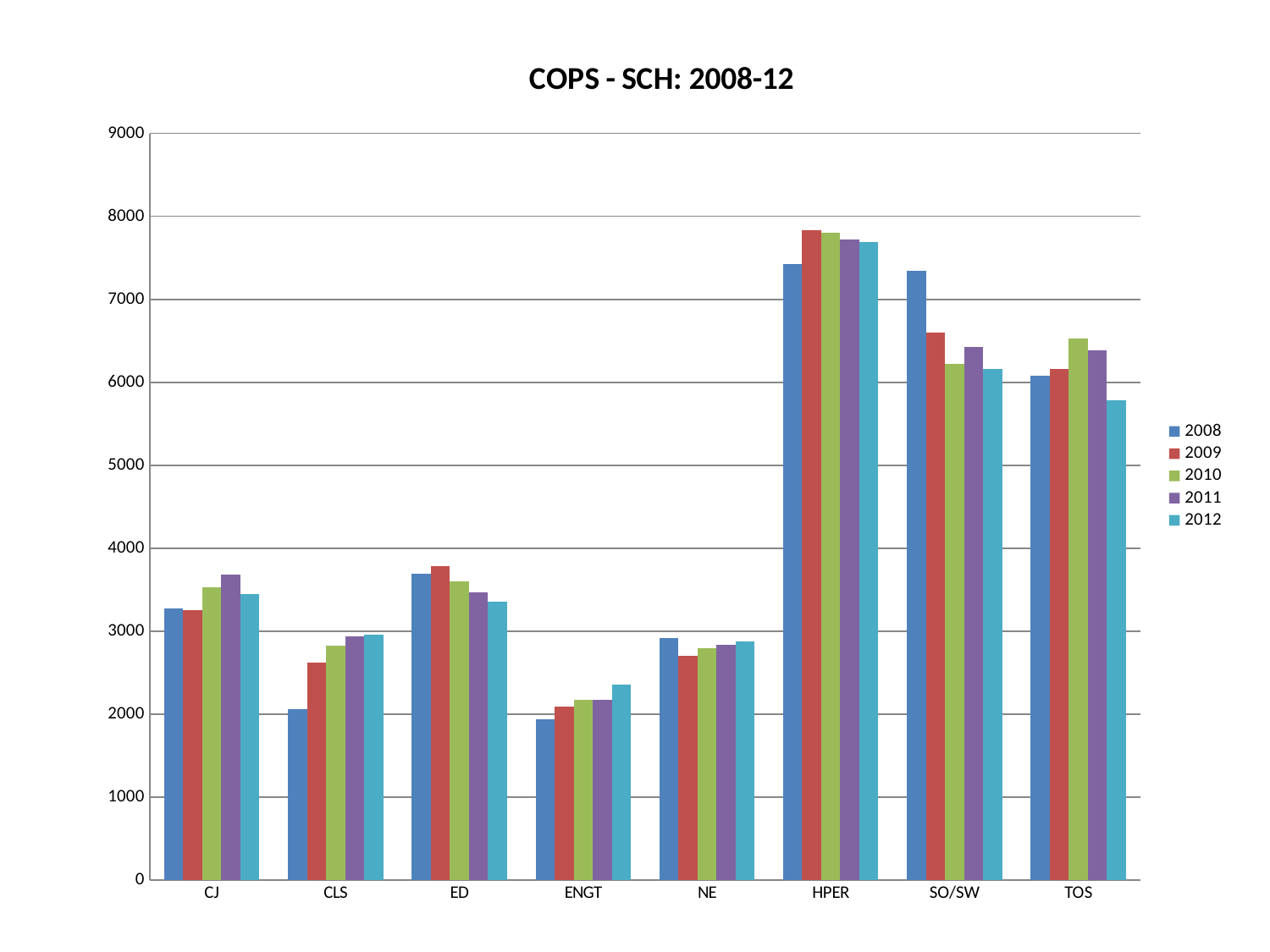
What kind of chart is shown on the slide? bar chart For SO/SW, which is larger: the value for 2008 or the value for 2009? 2008 How many series does the legend list? 5 Which category has the lowest value for 2012? ENGT Which category has the highest values across all years? HPER Is the value for ED in 2009 greater or less than 3000? greater Is the value for HPER in 2009 greater or less than 7000? greater For CLS, which is larger: the value for 2008 or the value for 2012? 2012 How many categories are shown on the x axis? 8 Is the value for TOS in 2012 greater or less than 6000? less Do the values for CLS rise or fall from 2008 to 2012? rise What is the title of the chart? COPS - SCH: 2008-12